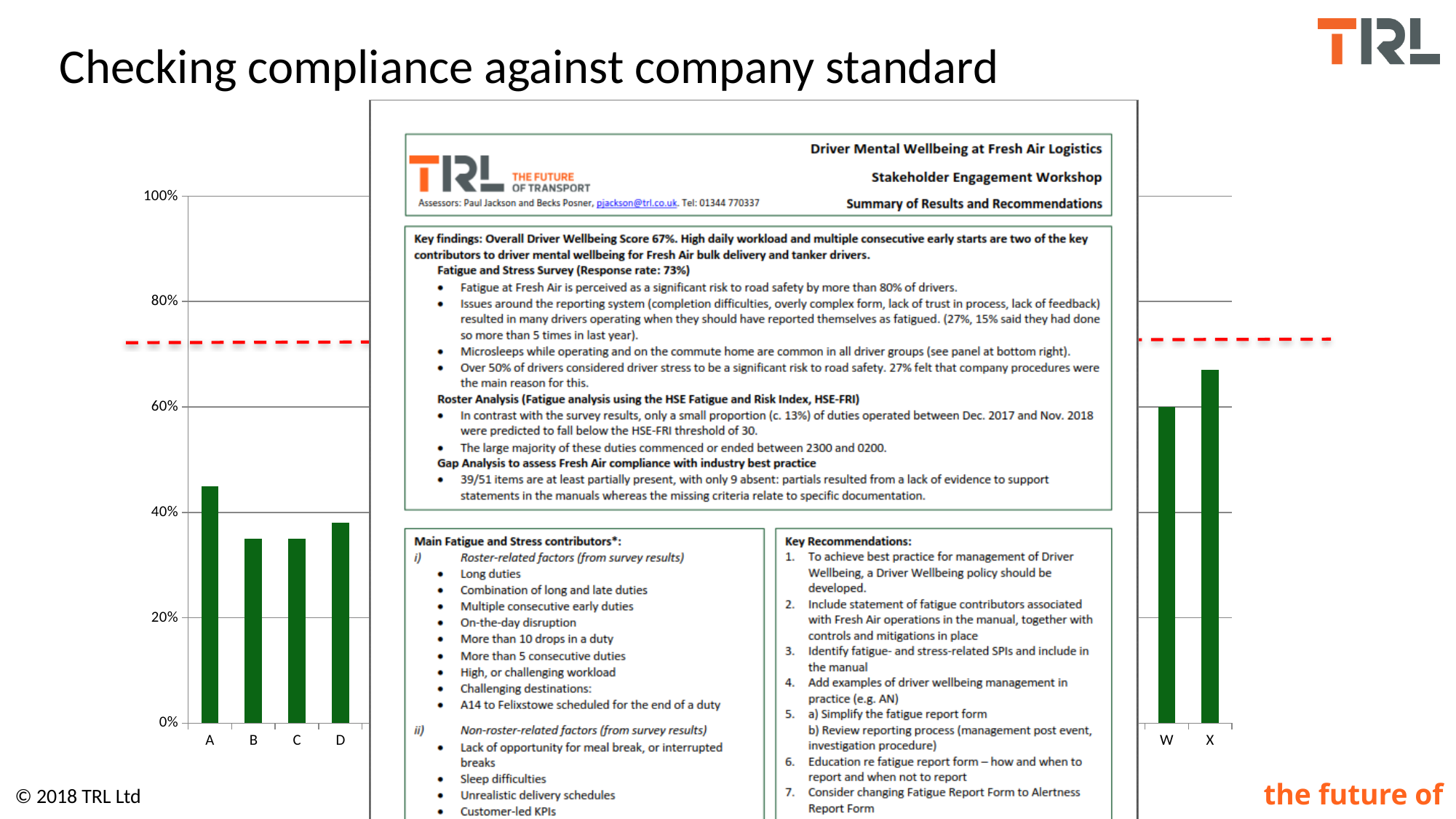
Which is larger, the value for category X or the value for category A? X What kind of chart is shown on the slide? bar chart Is the value for category A greater or less than 60%? less Is the value for category X greater or less than 60%? greater Among the visible categories A, B, C, D, W and X, which has the highest value? X Is the value for category C greater or less than 40%? less Which is larger, the value for category A or the value for category B? A Which is larger, the value for category W or the value for category X? X What colour are the bars in the chart? green